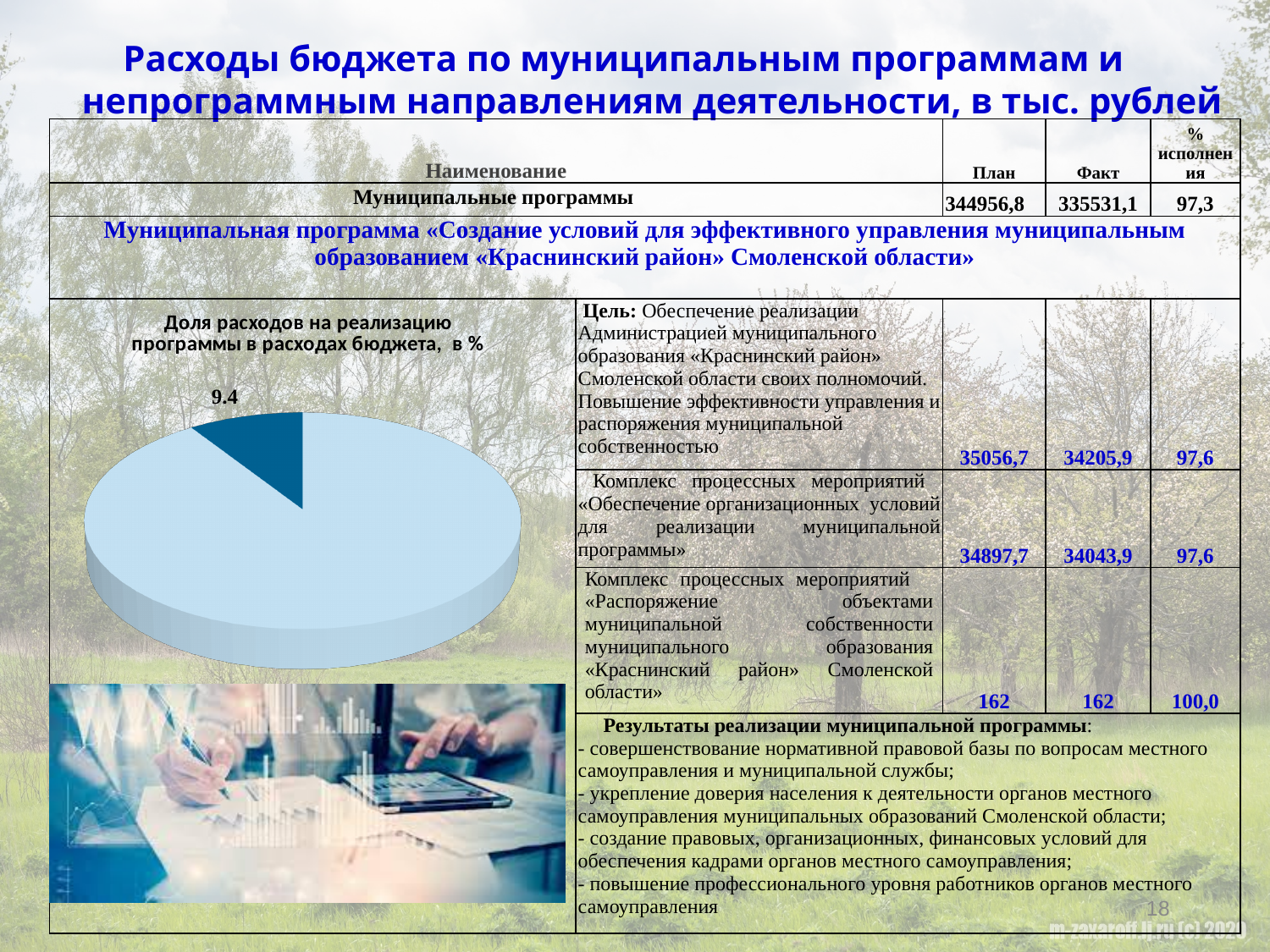
Is the value of the dark blue slice greater or less than 10? less What share of the budget expenditures does the dark blue slice represent, according to the data label? 9.4 What kind of chart is shown on the slide? pie chart What value is printed on the dark blue slice of the pie chart? 9.4 Which slice of the pie chart is larger, the dark blue one or the light blue one? the light blue one How many slices does the pie chart have? 2 Does the pie chart have a legend? No What is the title of the pie chart? Доля расходов на реализацию программы в расходах бюджета, в % Which slice of the pie chart is the smallest? the dark blue slice (9.4)